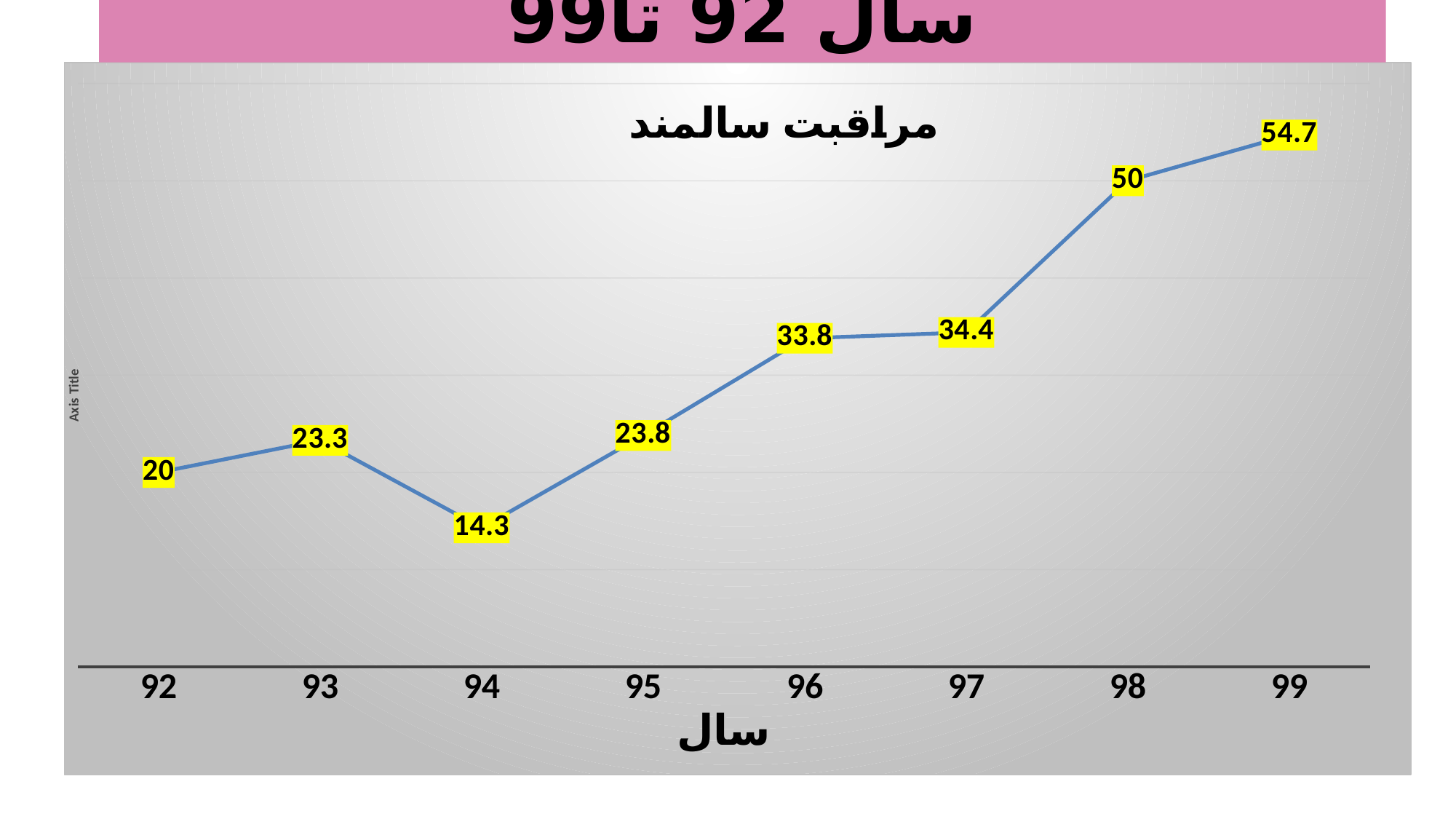
How many years are plotted on the x axis of the chart? 8 What is the value for year 96 in the chart? 33.8 What is the difference between the values for year 99 and year 98? 4.7 What is the title of the chart? مراقبت سالمند Which is larger, the value for year 95 or the value for year 93? 95 Which year has the highest value in the chart? 99 What is the value for year 98 in the chart? 50 What is the difference between the values for year 93 and year 94? 9 Do the values generally rise or fall from year 95 to year 99? rise Which year has the lowest value in the chart? 94 What kind of chart is shown on the slide? line chart What is the value for year 94 in the chart? 14.3